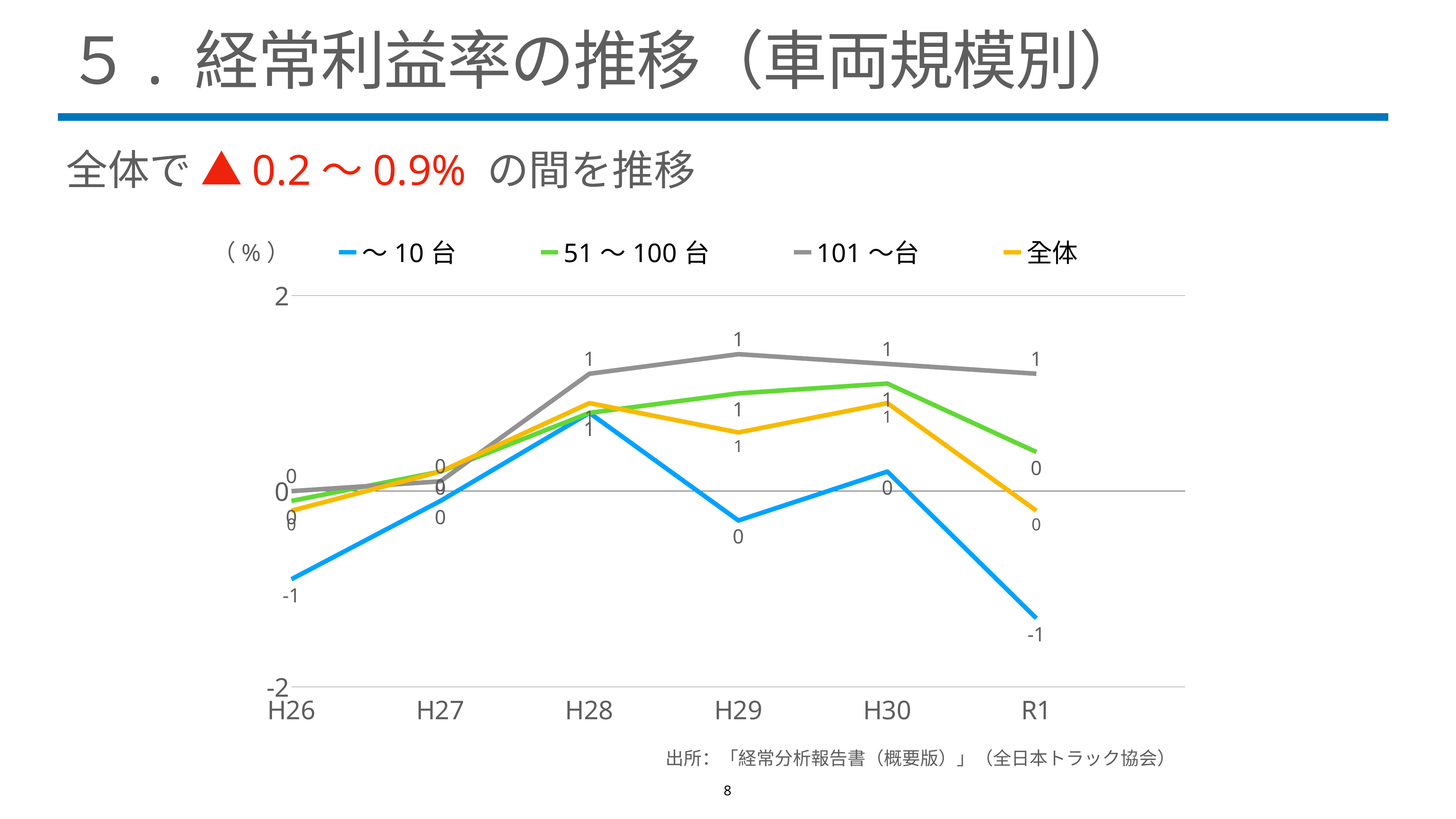
Does the ～10台 series rise or fall from H30 to R1? fall What is the data label for the ～10台 series at R1? -1 At R1, which is larger: the 51～100台 series or the 全体 series? 51～100台 How many years are shown on the x axis? 6 Which series has the lowest value at R1? ～10台 In which year is the ～10台 series at its highest? H28 Is the value for the ～10台 series at R1 greater or less than 0? less What is the data label for the ～10台 series at H26? -1 How many series does the legend list? 4 What kind of chart is shown on the slide? line chart Which series has the highest value at H29? 101～台 Is the value for the 101～台 series at H29 greater or less than 0? greater